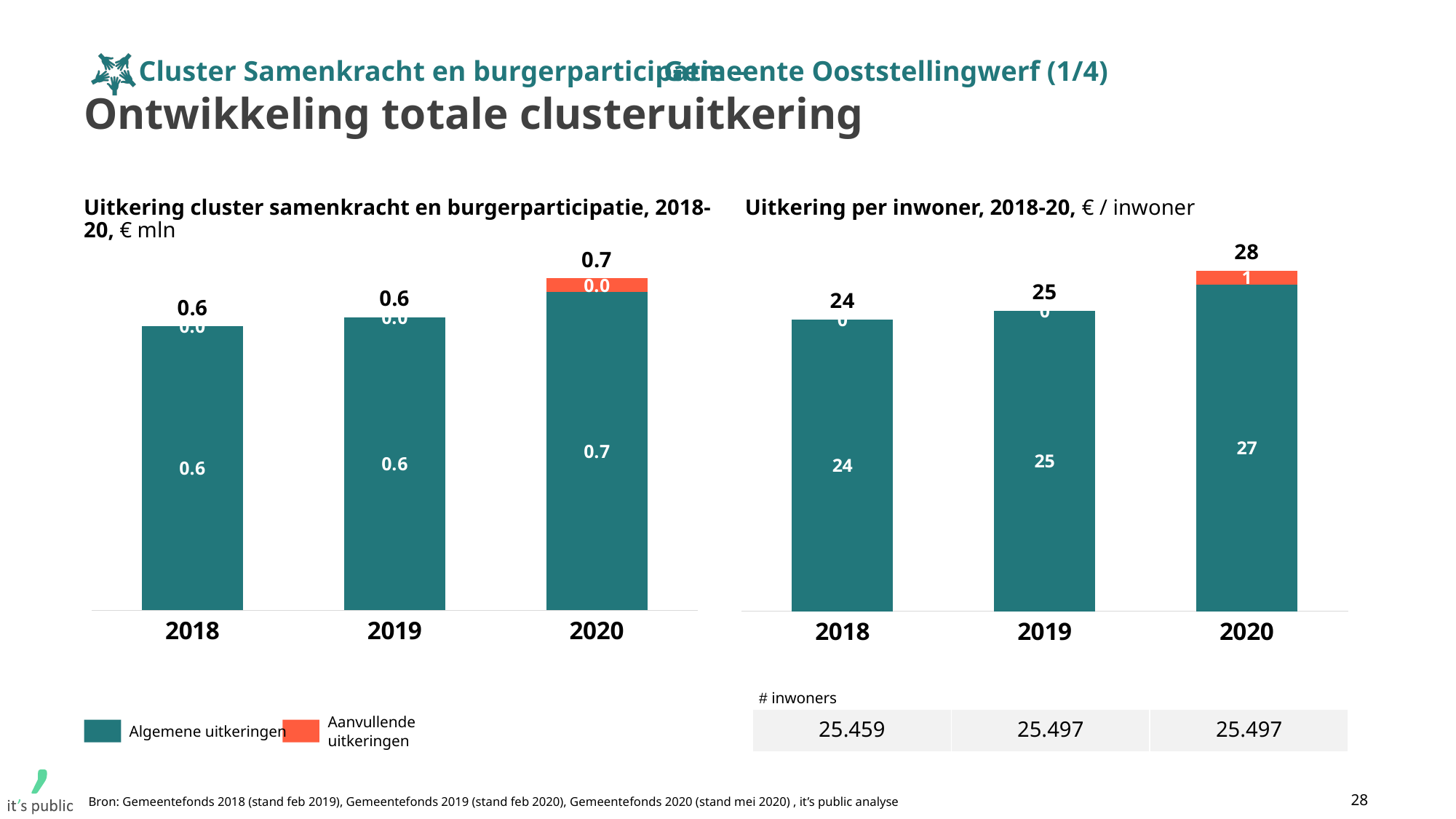
In the right chart (Uitkering per inwoner), what is the total value of the bar for 2019? 25 What kind of chart is the left chart (Uitkering cluster samenkracht en burgerparticipatie)? stacked bar chart In the left chart (Uitkering cluster samenkracht en burgerparticipatie), what is the total value of the bar for 2020? 0.7 In the right chart (Uitkering per inwoner), what is the value of Aanvullende uitkeringen for 2020? 1 In the right chart (Uitkering per inwoner), which year has the highest total? 2020 In the left chart (Uitkering cluster samenkracht en burgerparticipatie), what is the value of Aanvullende uitkeringen for 2020? 0.0 In the right chart (Uitkering per inwoner), what is the value of Algemene uitkeringen for 2020? 27 In the right chart (Uitkering per inwoner), what is the difference between the total for 2020 and the total for 2018? 4 How many series does the legend list? 2 In the right chart (Uitkering per inwoner), do the totals rise or fall from 2018 to 2020? rise In the left chart (Uitkering cluster samenkracht en burgerparticipatie), what is the value of Algemene uitkeringen for 2018? 0.6 In the right chart (Uitkering per inwoner), which year has the lowest total? 2018